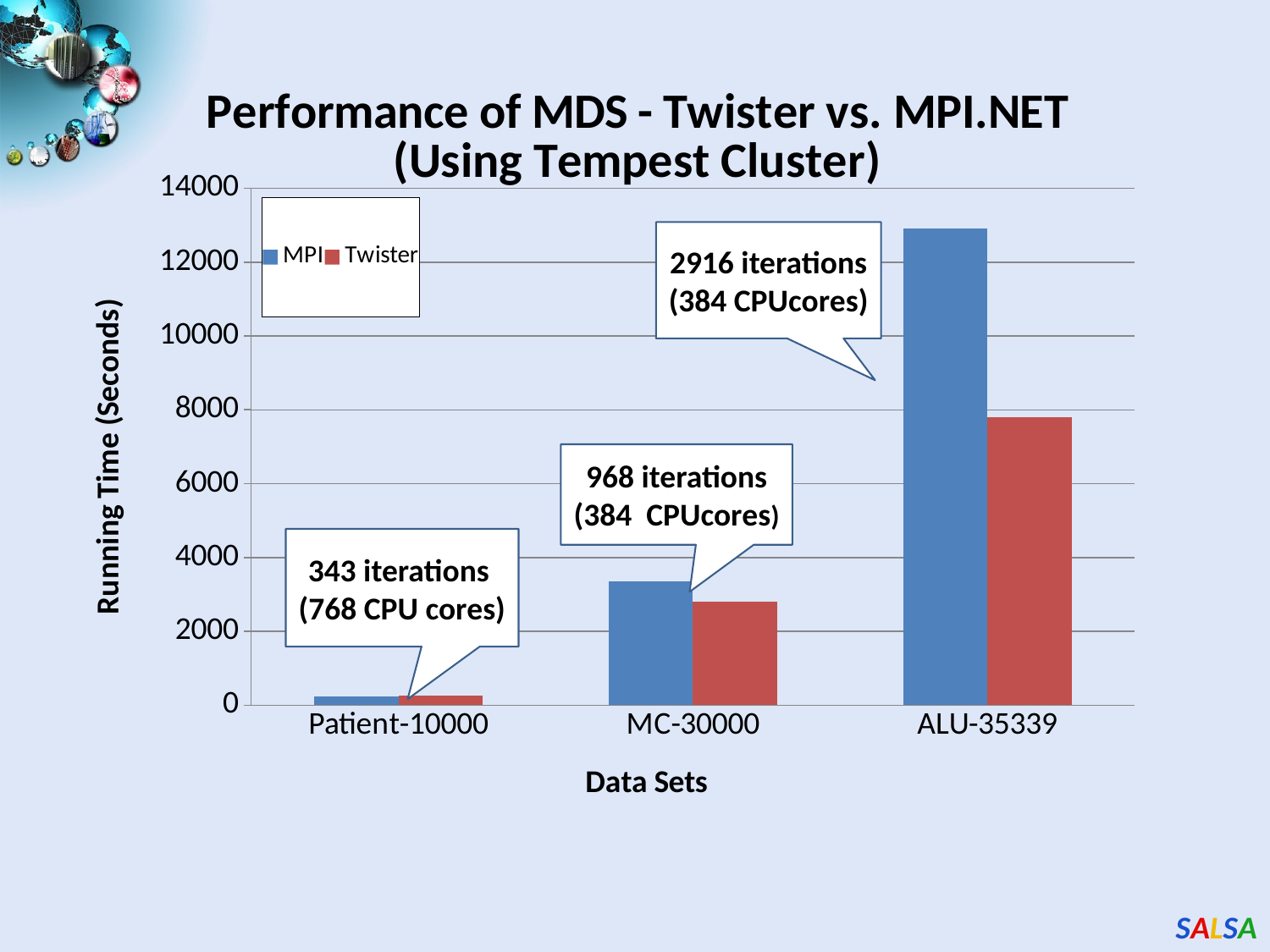
Which data set has the highest MPI running time? ALU-35339 Is the MPI running time for ALU-35339 greater or less than 12000? greater Is the MPI running time for MC-30000 greater or less than 4000? less Do the MPI running times rise or fall moving from Patient-10000 to ALU-35339 along the x axis? rise How many series does the legend list? 2 What is the label of the y axis? Running Time (Seconds) How many data sets (categories) are shown on the x axis? 3 What kind of chart is shown on the slide? Bar chart For ALU-35339, which series has the larger running time, MPI or Twister? MPI For MC-30000, which series has the larger running time, MPI or Twister? MPI Is the Twister running time for ALU-35339 greater or less than 6000? greater Which data set has the lowest Twister running time? Patient-10000